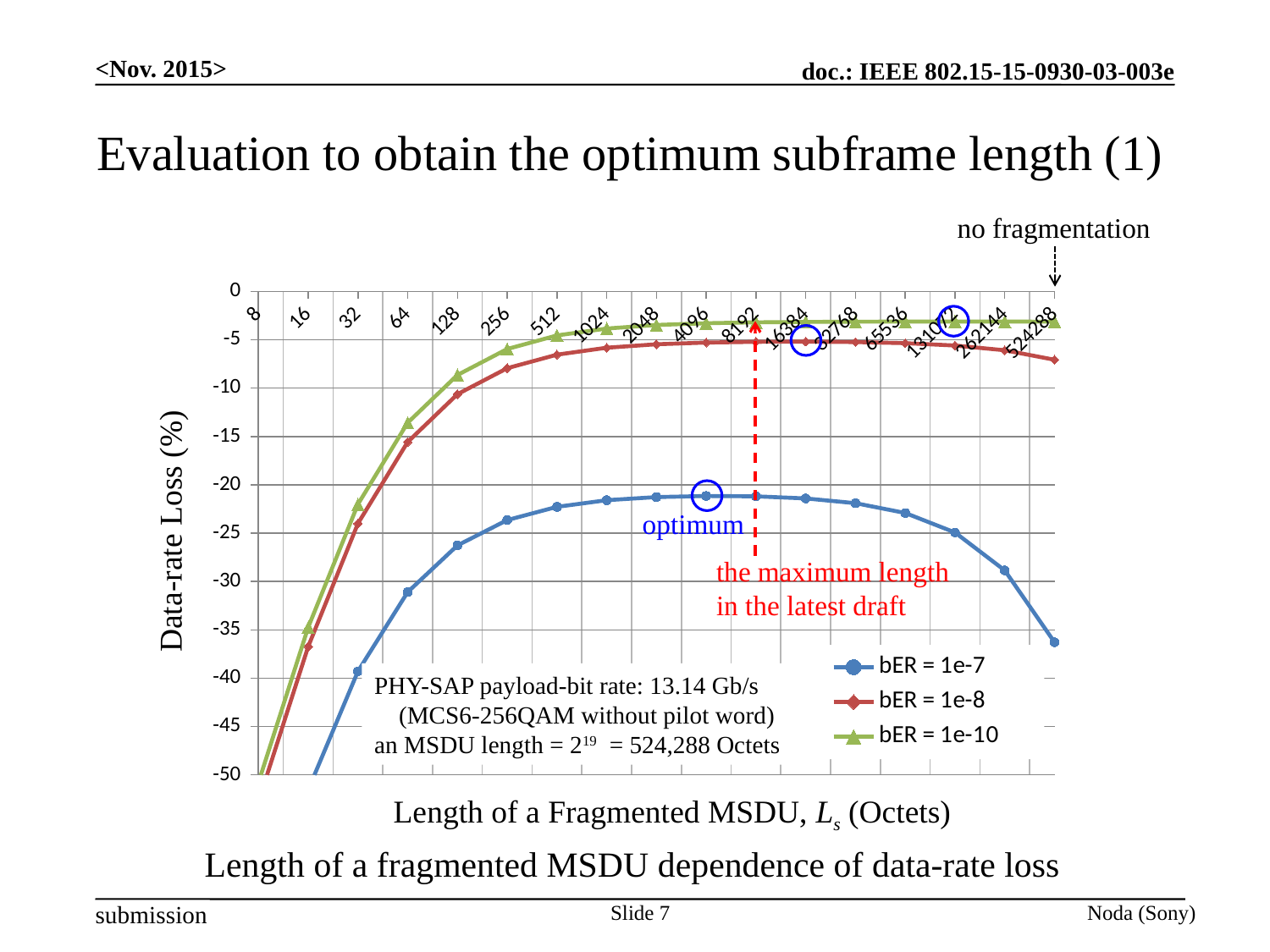
Which series has the lowest data-rate loss value at a length of 524288? bER = 1e-7 What is the title of the chart's y axis? Data-rate Loss (%) Is the value for bER = 1e-7 at a length of 524288 greater or less than -30? less Does the bER = 1e-7 series rise or fall as the length increases from 8 to 8192? rise Is the value for bER = 1e-7 at a length of 8192 greater or less than -15? less How many x-axis categories (fragmented MSDU lengths) are plotted on the chart? 17 At a length of 64, which series has the higher data-rate loss value, bER = 1e-10 or bER = 1e-7? bER = 1e-10 Is the value for bER = 1e-8 at a length of 16 greater or less than -30? less Which series has the highest data-rate loss value at a length of 32768? bER = 1e-10 How many series does the chart legend list? 3 What kind of chart is shown on the slide? line chart